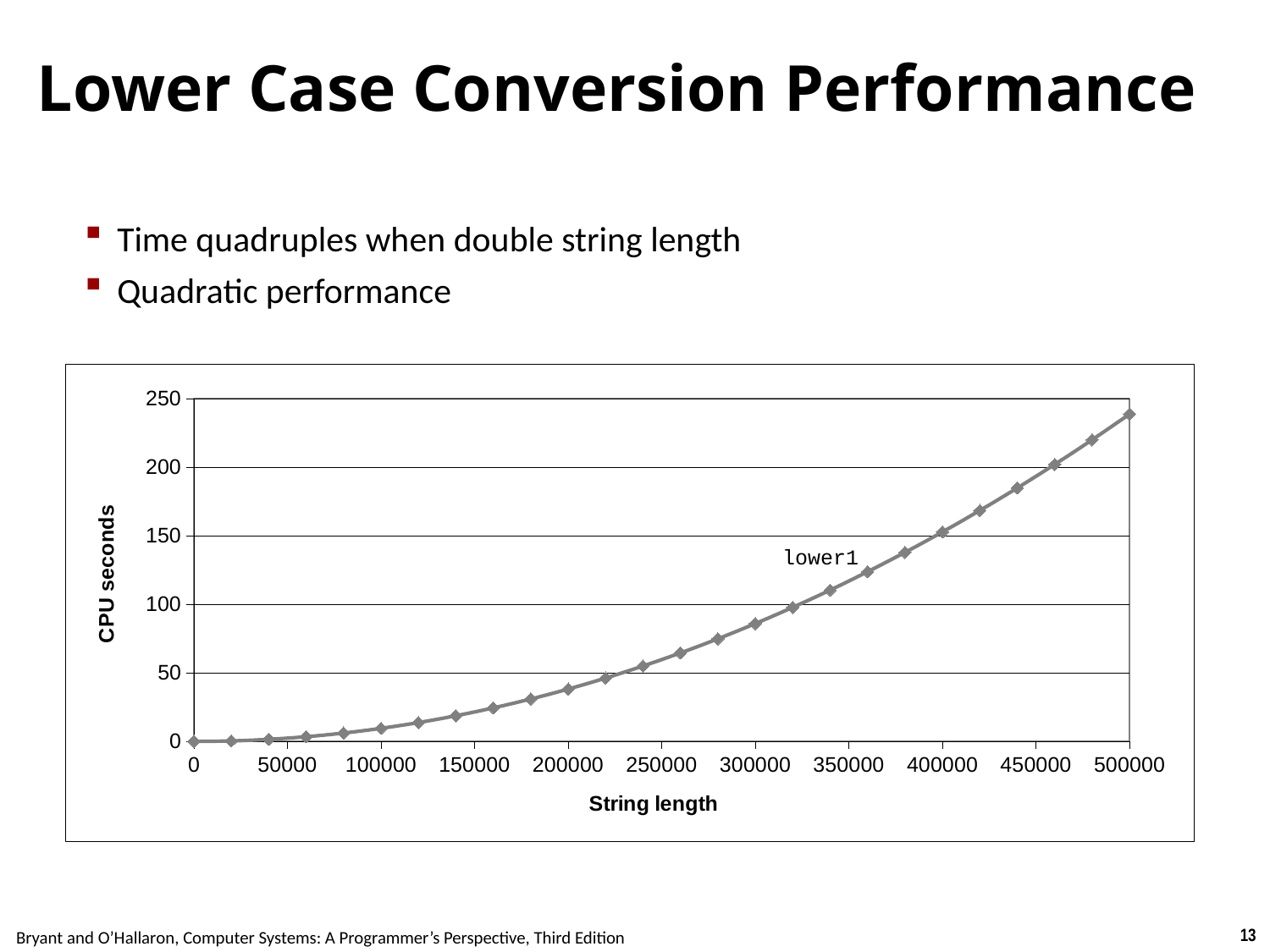
What is the name of the series plotted on the chart? lower1 Is the CPU seconds value at string length 500000 greater or less than 200? greater Is the CPU seconds value at string length 200000 greater or less than 50? less What kind of chart is shown on the slide? line chart How many series are plotted on the chart? 1 At which string length is the CPU seconds value lowest? 0 Is the CPU seconds value at string length 300000 greater or less than 100? less Which has a larger CPU seconds value: string length 400000 or string length 200000? 400000 What is the label of the y axis? CPU seconds At which string length is the CPU seconds value highest? 500000 Do the CPU seconds rise or fall as string length increases? rise What is the label of the x axis? String length